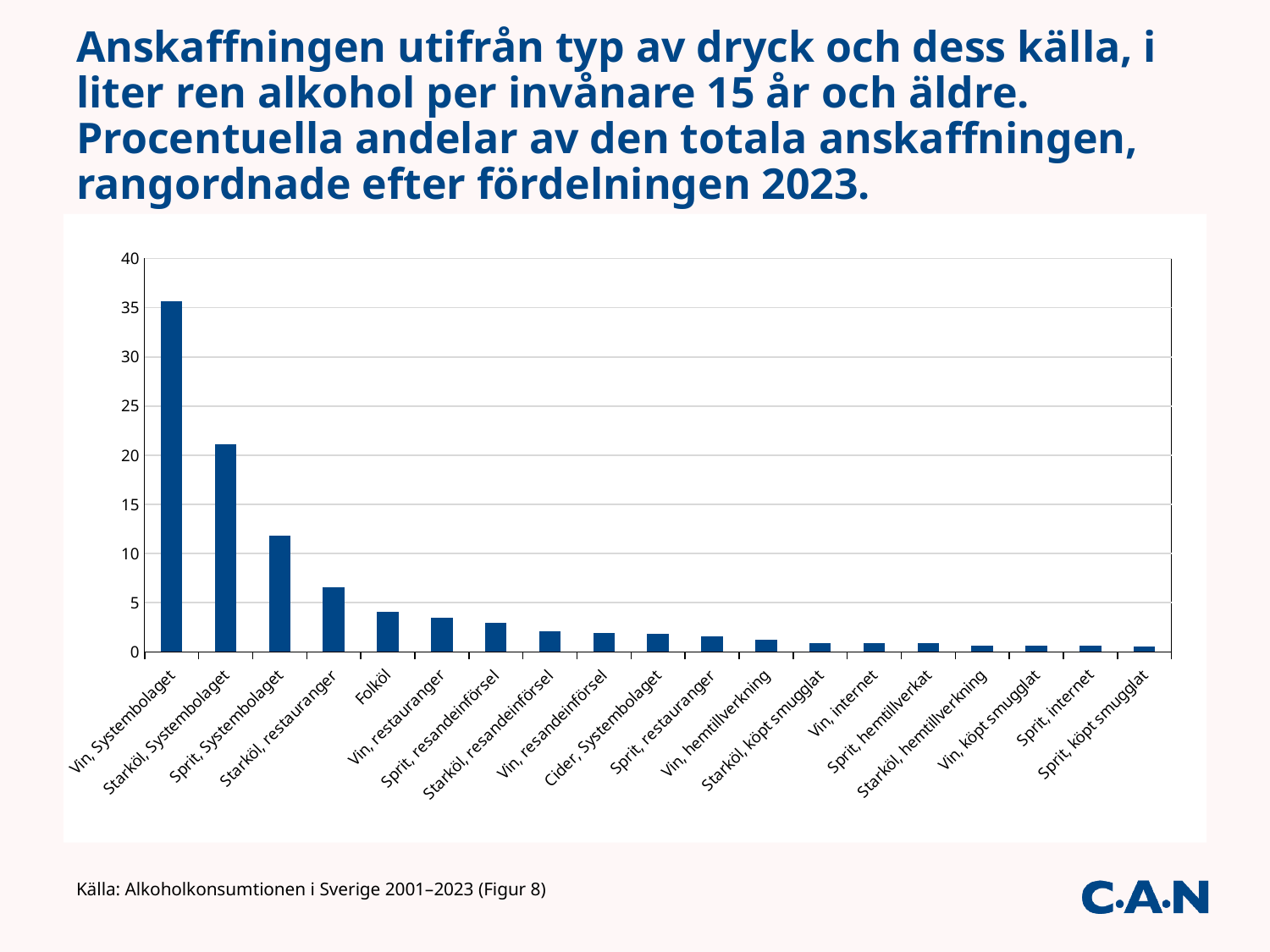
Is the value for Folköl greater or less than 5? less What is the highest value shown on the y axis of the chart? 40 Which category has the highest value in the chart? Vin, Systembolaget Is the value for Vin, hemtillverkning greater or less than 5? less Is the value for Vin, Systembolaget greater or less than 30? greater How many categories are shown on the x axis of the chart? 19 Do the values rise or fall moving from left to right along the x axis? fall Which is larger, the value for Starköl, Systembolaget or the value for Sprit, Systembolaget? Starköl, Systembolaget What kind of chart is shown on the slide? bar chart